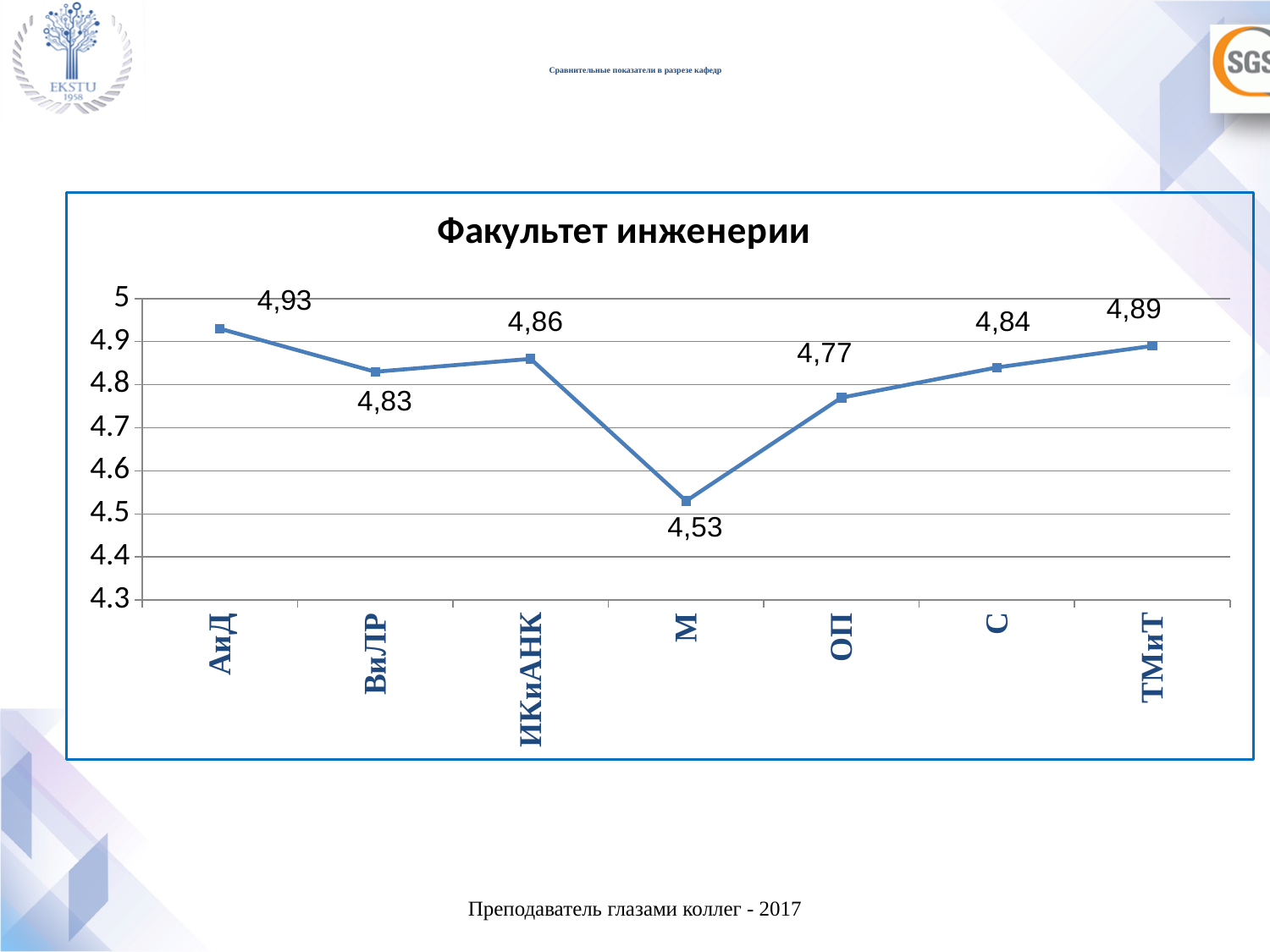
What is the difference between the values for АиД and М? 0,40 What is the value for ОП? 4,77 How many categories are plotted on the x axis? 7 Which is larger, the value for ВиЛР or the value for ИКиАНК? ИКиАНК What is the title of the chart? Факультет инженерии What is the value for АиД? 4,93 Is the value for ОП greater or less than 4.8? less Which category has the highest value? АиД What is the value for ТМиТ? 4,89 What kind of chart is shown? line chart Which category has the lowest value? М What is the value for М? 4,53